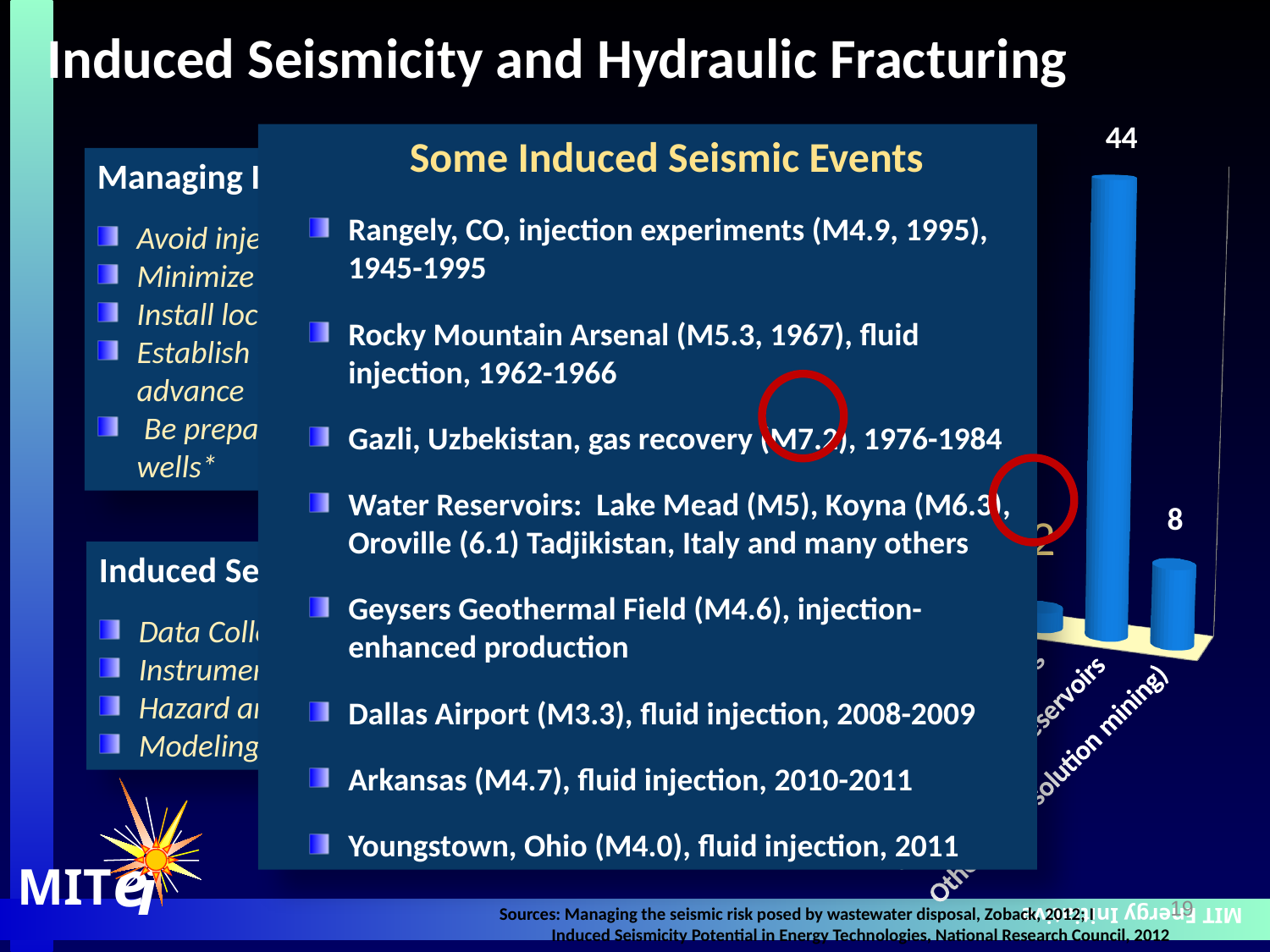
What is the difference between the tallest bar (44) and the rightmost bar (8)? 36 What colour are the bars in the chart? blue Which is larger: the tallest bar's value or the rightmost bar's value? the tallest bar (44) What is the value printed above the tallest bar in the chart? 44 What kind of chart is shown on the right side of the slide? bar chart What is the highest value labelled on the chart? 44 What is the value printed above the rightmost bar in the chart? 8